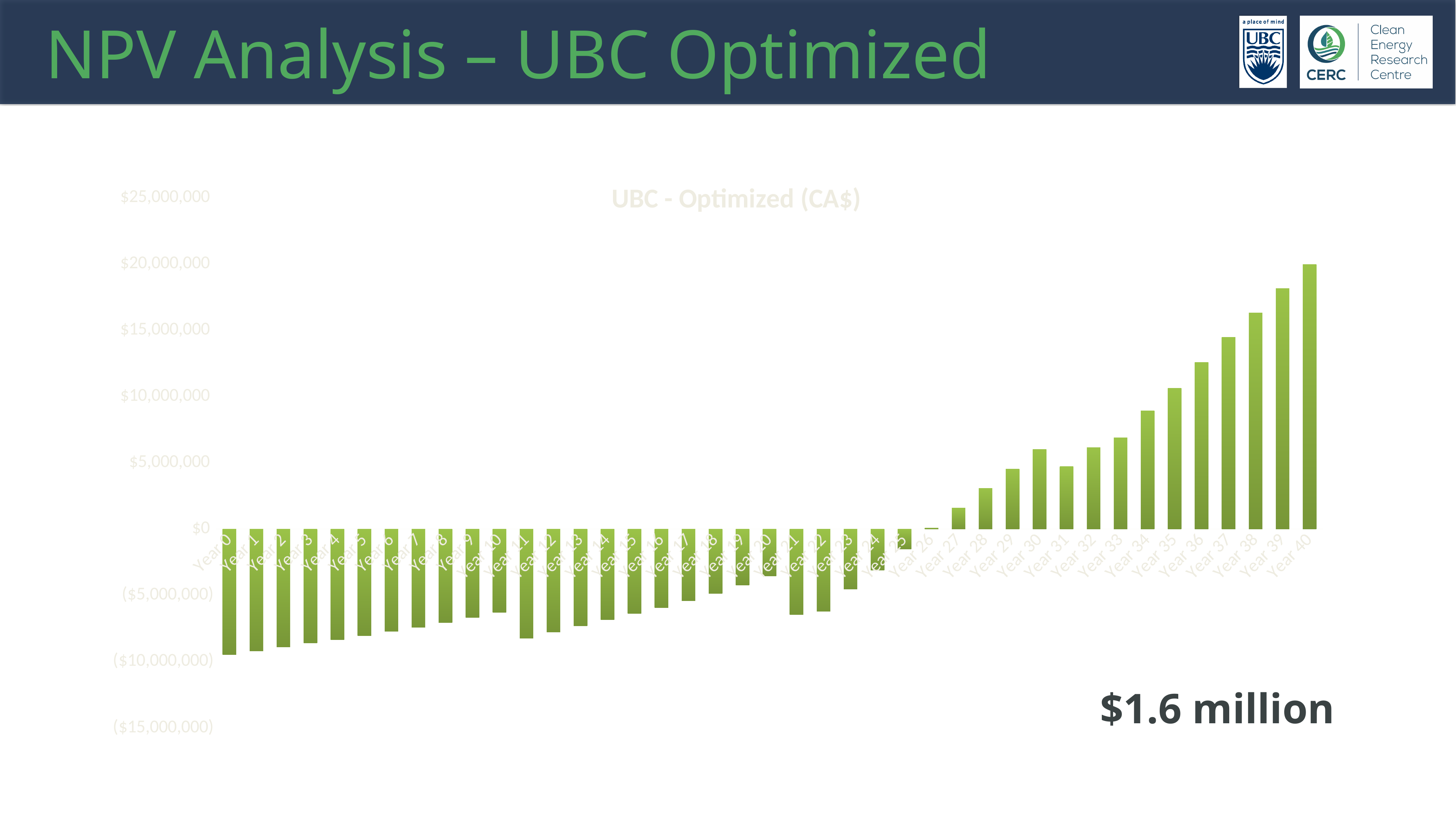
Which is larger, the value for Year 10 or the value for Year 11? Year 10 What kind of chart is shown on the slide? bar chart Is the value for Year 27 greater or less than $5,000,000? less Is the value for Year 36 greater or less than $10,000,000? greater Do the values generally rise or fall from Year 26 to Year 40? rise Which year has the highest value on the chart? Year 40 Is the value for Year 0 greater or less than ($5,000,000)? less What is the title of the chart? UBC - Optimized (CA$) How many years (bars) are plotted on the chart? 41 What dollar figure is printed in large text below the chart? $1.6 million Which year has the lowest value on the chart? Year 0